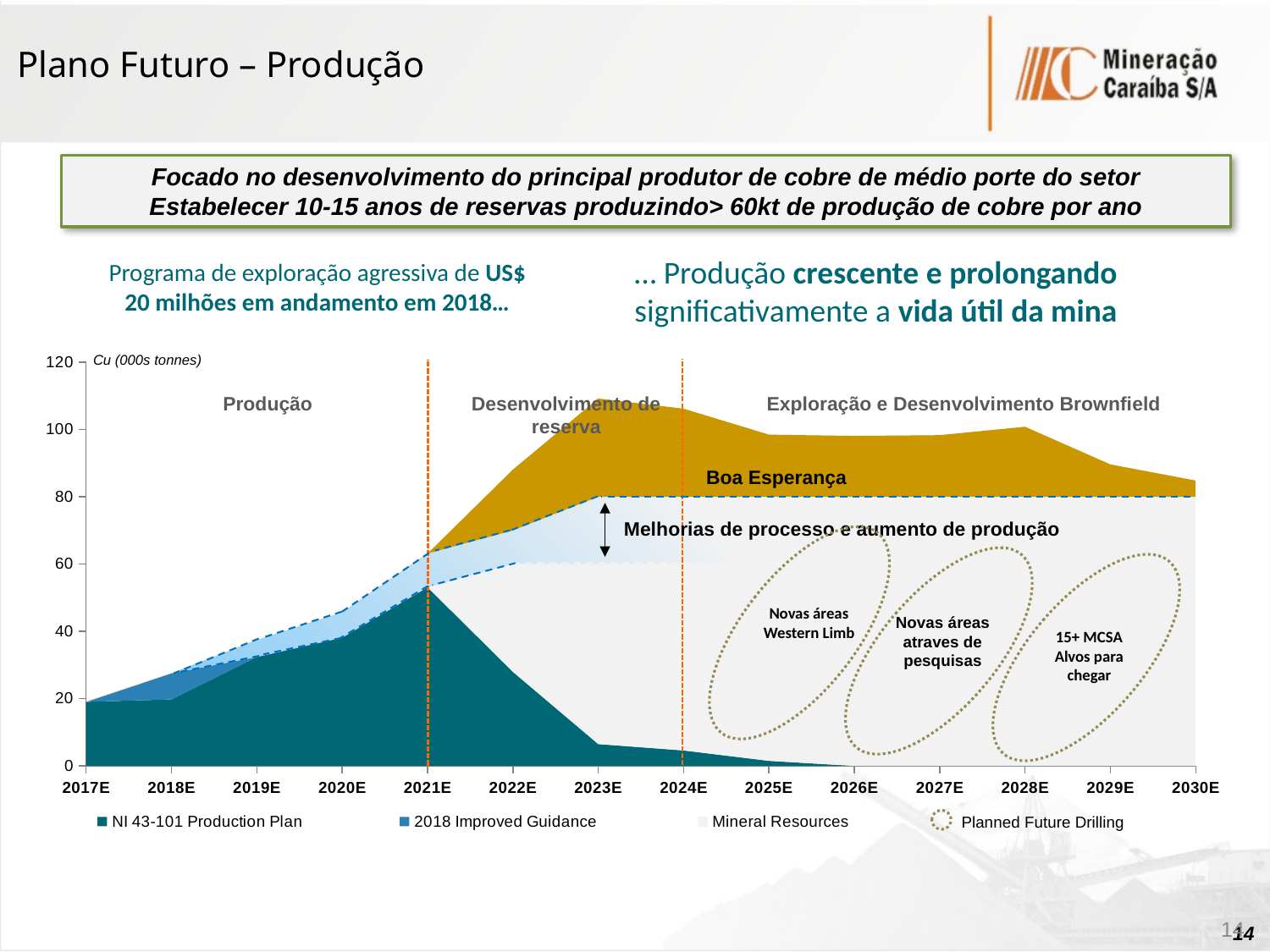
Does the NI 43-101 Production Plan rise or fall between 2021E and 2023E? fall What unit is stated at the top of the y axis of the chart? Cu (000s tonnes) How many years are shown along the x axis of the chart? 14 Is the NI 43-101 Production Plan value for 2021E greater or less than 60? less Does the NI 43-101 Production Plan rise or fall between 2017E and 2021E? rise Is the NI 43-101 Production Plan value for 2023E greater or less than 20? less How many entries does the chart legend list? 4 In which year does the NI 43-101 Production Plan area reach its highest value? 2021E Is the top of the Mineral Resources area in 2023E greater or less than 100? less What is the first year shown on the x axis of the chart? 2017E What kind of chart is shown on the slide? Area chart